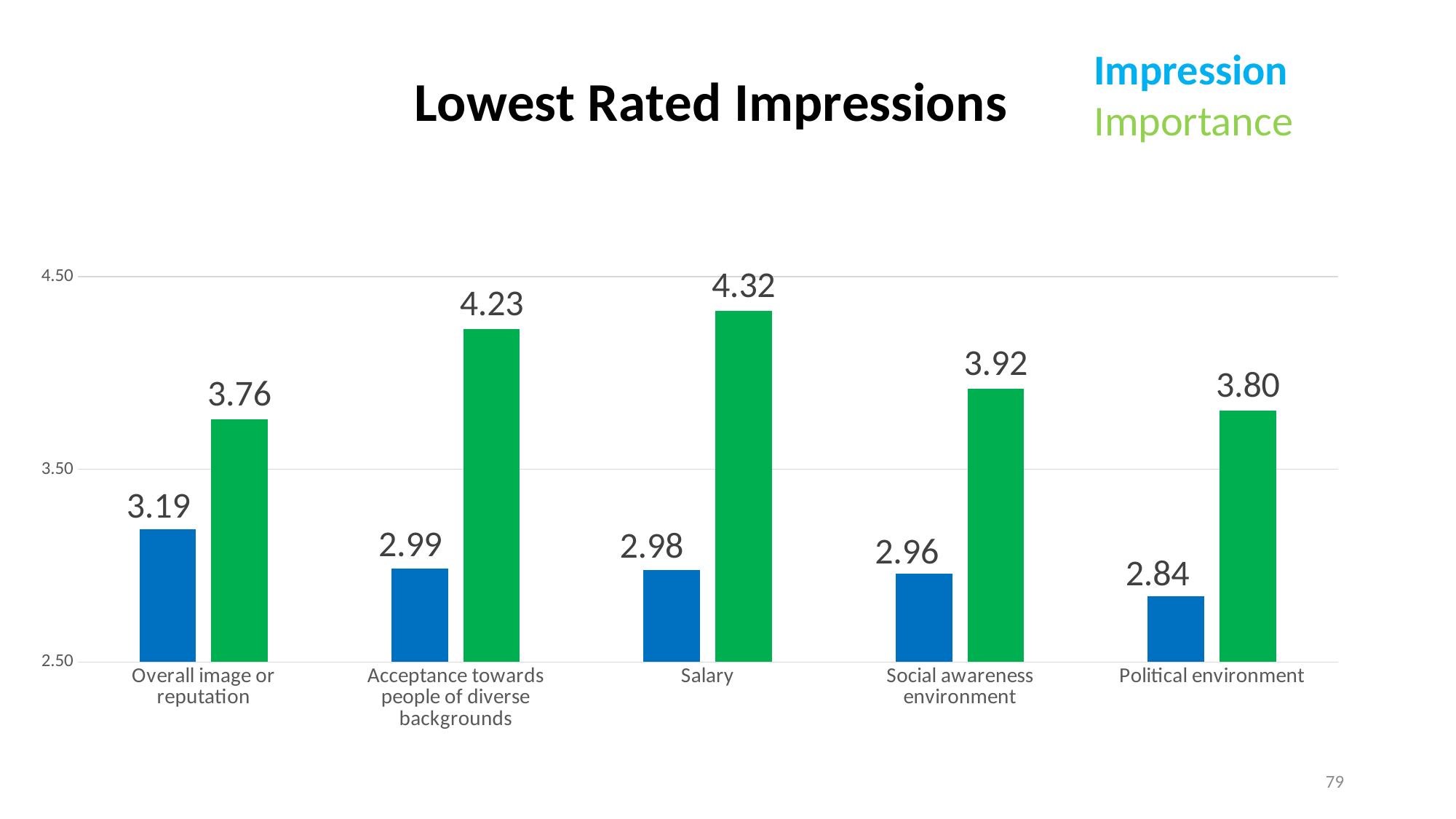
What type of chart is shown on the slide? bar chart Which is larger: the Importance value for Social awareness environment or the Importance value for Overall image or reputation? Social awareness environment Which category has the highest Importance value? Salary How many categories are shown on the x axis? 5 What is the Impression value for Salary? 2.98 What is the difference between the Importance and Impression values for Salary? 1.34 What is the Importance value for Political environment? 3.80 How many series does the legend list? 2 Which category has the lowest Impression value? Political environment What is the Impression value for Acceptance towards people of diverse backgrounds? 2.99 What is the difference between the Importance values for Acceptance towards people of diverse backgrounds and Overall image or reputation? 0.47 Is the Impression value for Overall image or reputation greater or less than 3.50? less